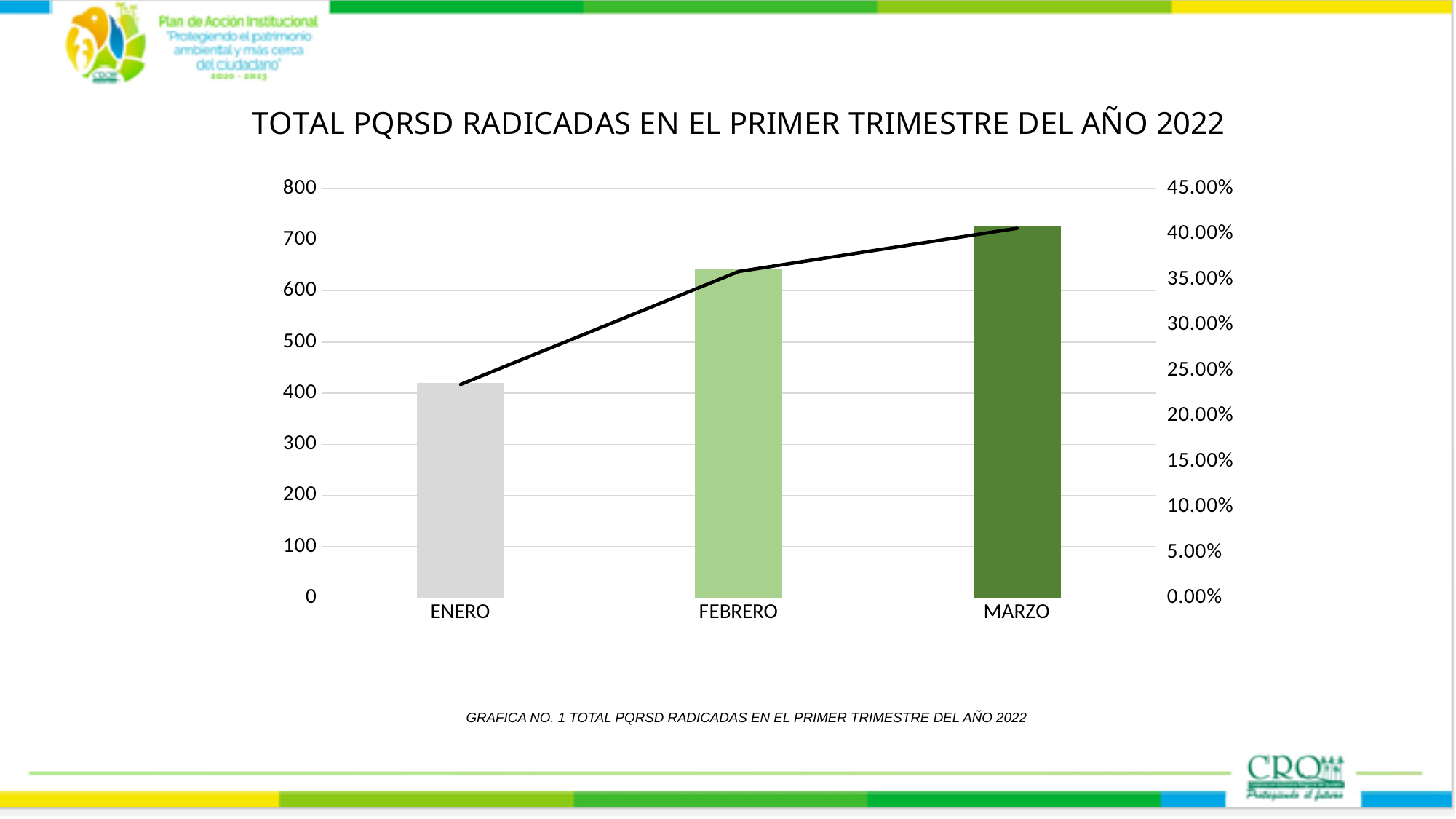
Is the bar value for ENERO greater or less than 500? less Which month has the lowest bar in the chart? ENERO What is the title of the chart? TOTAL PQRSD RADICADAS EN EL PRIMER TRIMESTRE DEL AÑO 2022 How many months are shown on the x axis of the chart? 3 Which month has the highest bar in the chart? MARZO Which bar is taller, FEBRERO or MARZO? MARZO Is the bar value for FEBRERO greater or less than 600? greater What kind of chart is shown on the slide? Bar chart with a line Do the bar values rise or fall from ENERO to MARZO? rise Which bar is taller, ENERO or FEBRERO? FEBRERO What colour is the bar for MARZO? Dark green Is the bar value for MARZO greater or less than 700? greater